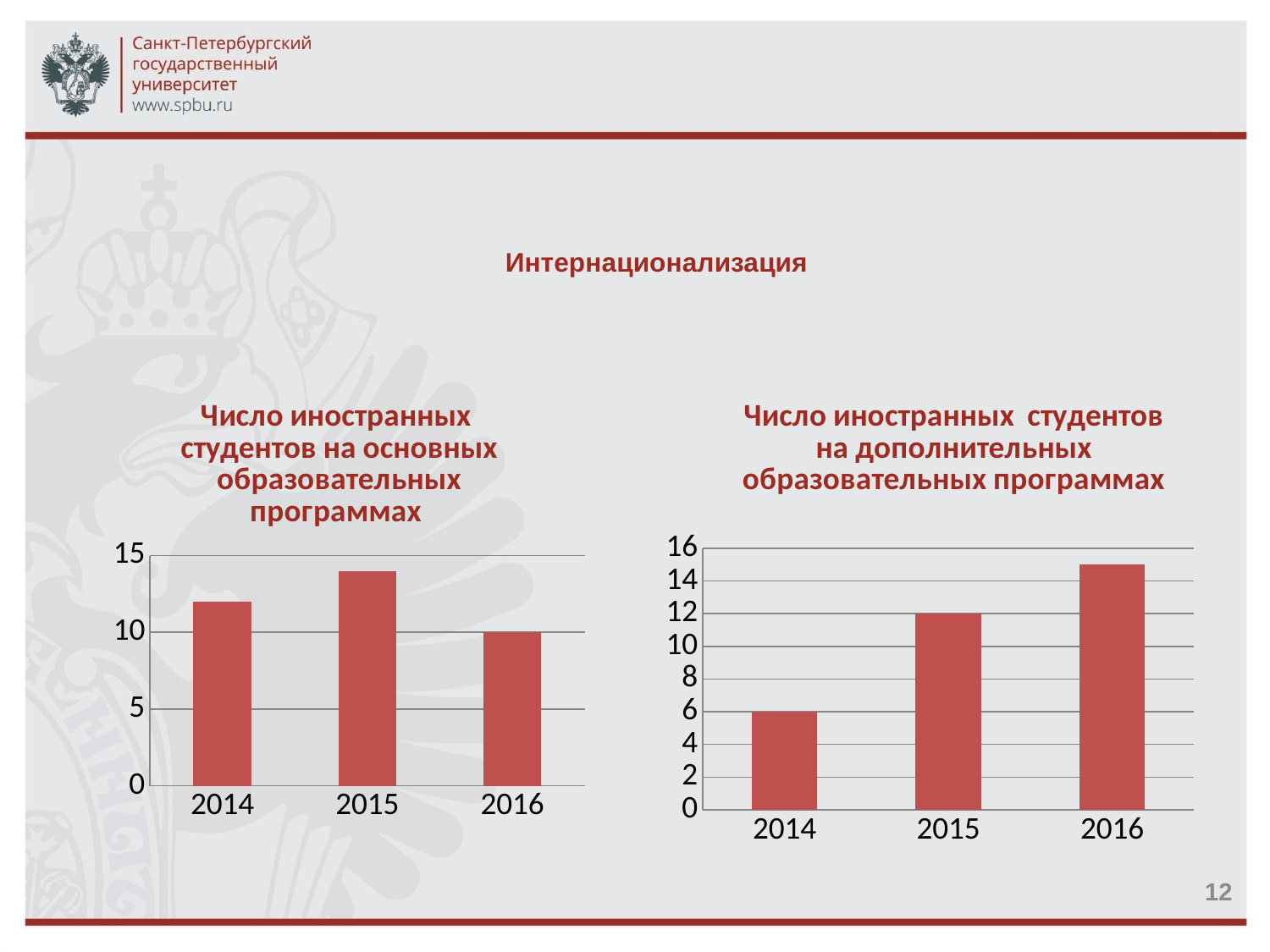
How many years are shown on the x axis of the left chart (Число иностранных студентов на основных образовательных программах)? 3 In the right chart (Число иностранных студентов на дополнительных образовательных программах), do the values rise or fall from 2014 to 2016? rise In the right chart (Число иностранных студентов на дополнительных образовательных программах), is the value for 2016 greater or less than 14? greater In the right chart (Число иностранных студентов на дополнительных образовательных программах), which year has the highest value? 2016 In the right chart (Число иностранных студентов на дополнительных образовательных программах), what is the value for 2014? 6 What kind of chart is the right chart (Число иностранных студентов на дополнительных образовательных программах)? bar chart In the left chart (Число иностранных студентов на основных образовательных программах), is the value for 2014 greater or less than 10? greater In the left chart (Число иностранных студентов на основных образовательных программах), which year has the highest value? 2015 In the left chart (Число иностранных студентов на основных образовательных программах), which year has the lowest value? 2016 In the left chart (Число иностранных студентов на основных образовательных программах), what is the value for 2016? 10 In the right chart (Число иностранных студентов на дополнительных образовательных программах), what is the value for 2015? 12 In the right chart (Число иностранных студентов на дополнительных образовательных программах), what is the difference between the values for 2015 and 2014? 6